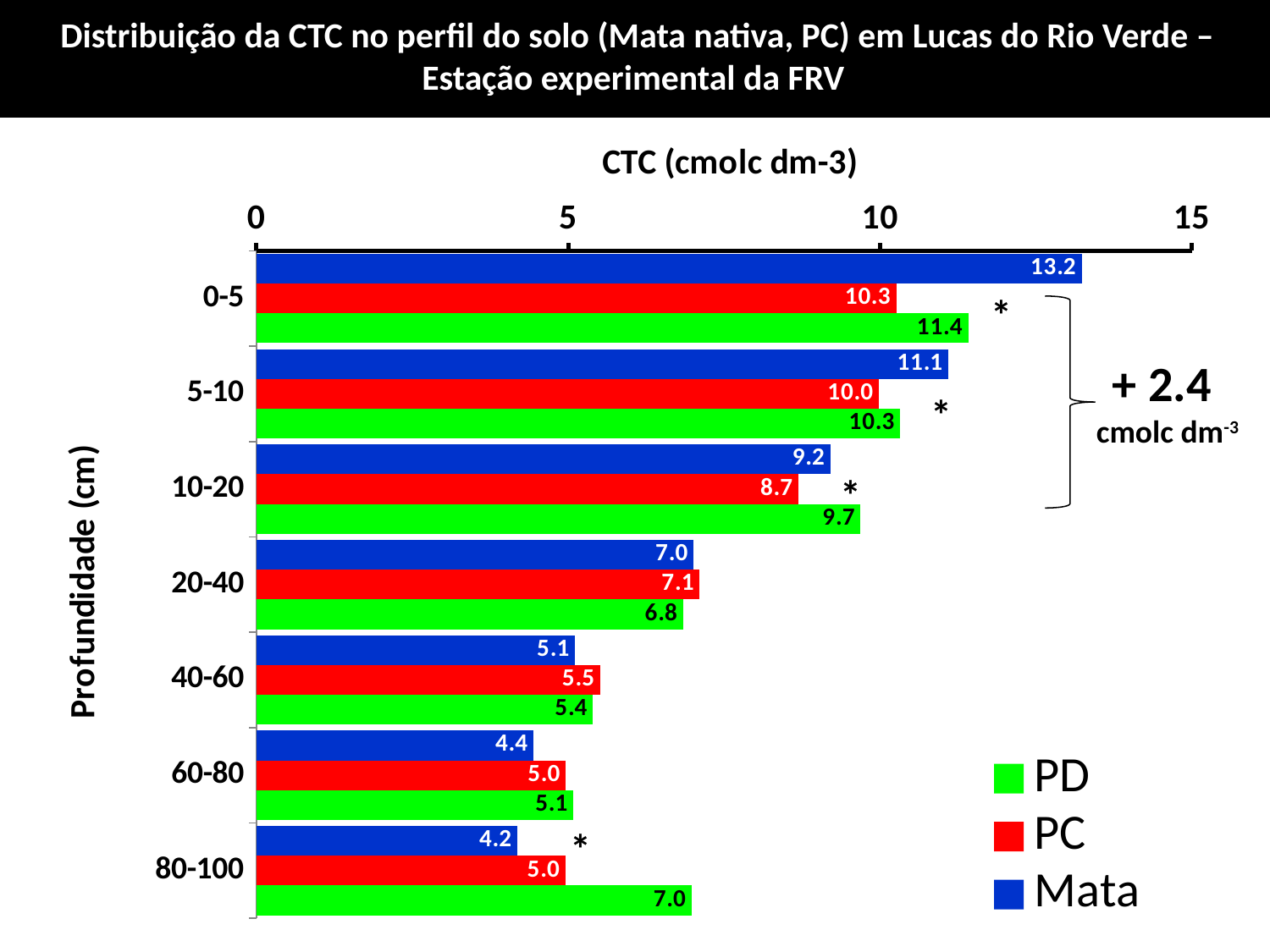
What is the difference between the Mata and PC values at the 0-5 cm depth? 2.9 What is the CTC value for Mata at the 0-5 cm depth? 13.2 At which depth is the Mata series lowest? 80-100 What is the CTC value for PC at the 10-20 cm depth? 8.7 How many depth categories are shown on the chart? 7 Which colour represents the PC series in the legend? Red At the 80-100 cm depth, which series has the larger value, PD or Mata? PD At which depth is the Mata series highest? 0-5 Does the Mata series rise or fall as depth increases from 0-5 to 80-100 cm? Fall What kind of chart is shown on the slide? Bar chart How many series does the legend list? 3 What is the CTC value for PD at the 80-100 cm depth? 7.0